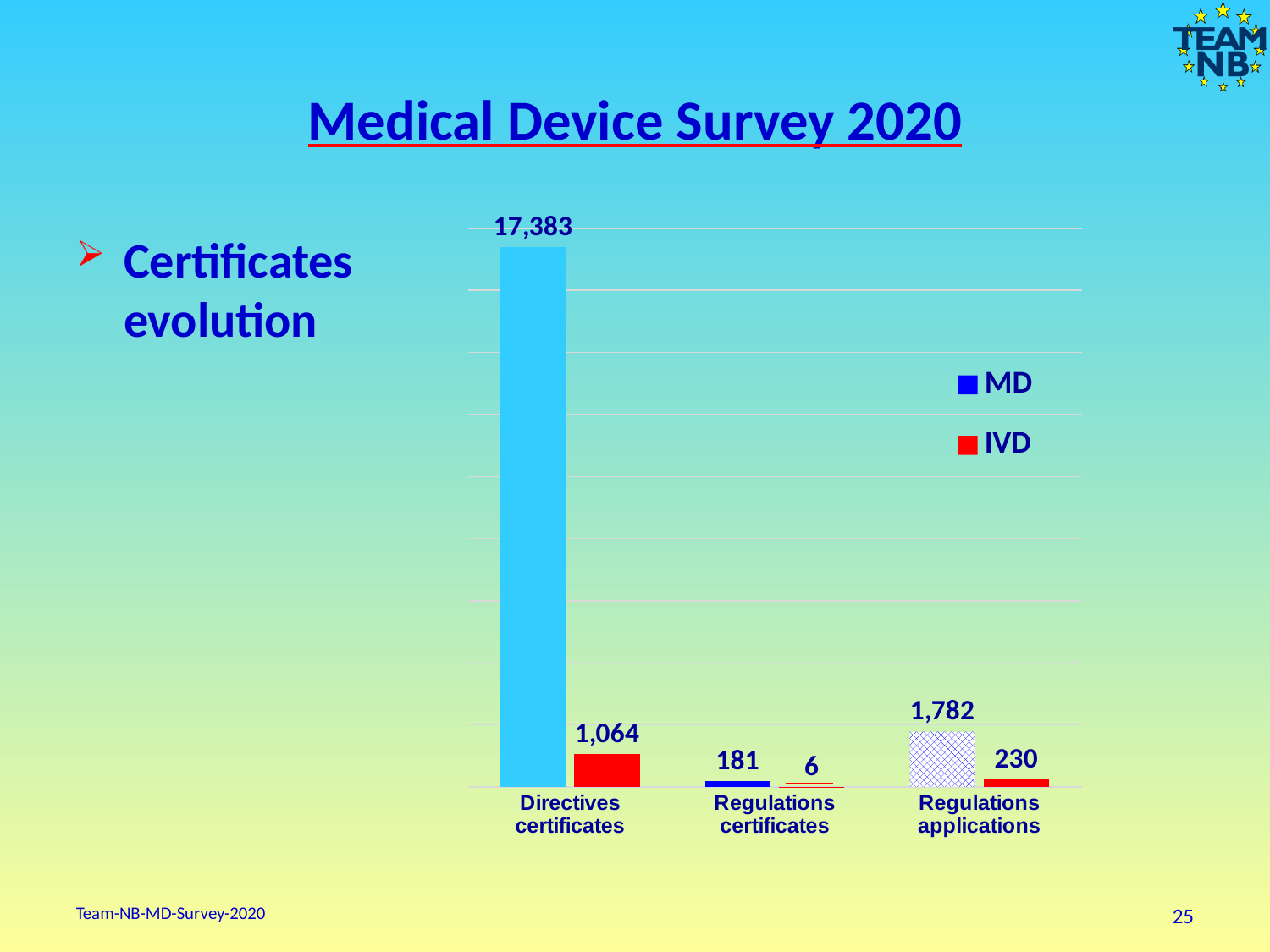
Which category has the highest MD value? Directives certificates What is the IVD value for Regulations certificates? 6 What is the MD value for Directives certificates? 17,383 Which category has the lowest IVD value? Regulations certificates What is the MD value for Regulations certificates? 181 How many categories are shown on the x axis? 3 What is the IVD value for Regulations applications? 230 Which is larger, the MD value for Regulations certificates or the IVD value for Regulations applications? IVD value for Regulations applications What is the difference between the MD and IVD values for Regulations applications? 1,552 How many series does the legend list? 2 What is the IVD value for Directives certificates? 1,064 What is the MD value for Regulations applications? 1,782